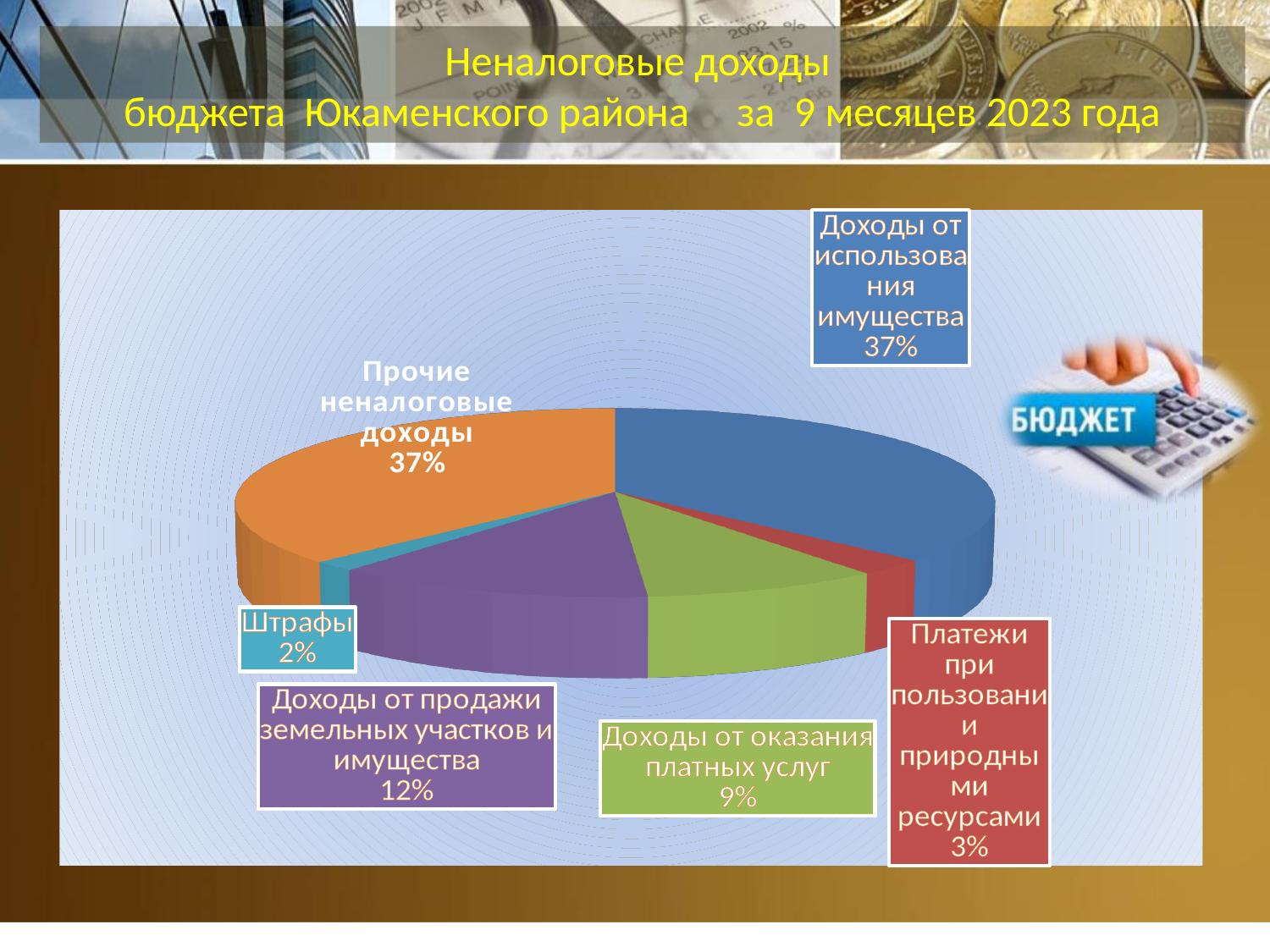
Which category has the smallest share of the pie? Штрафы Which is larger: Доходы от продажи земельных участков и имущества or Доходы от оказания платных услуг? Доходы от продажи земельных участков и имущества What share of the pie is labelled for Доходы от использования имущества? 37% How many categories (slices) does the pie chart show? 6 What kind of chart is shown on the slide? Pie chart What percentage is shown for Доходы от оказания платных услуг? 9% What is the difference between the shares of Прочие неналоговые доходы and Доходы от продажи земельных участков и имущества? 25 percentage points What percentage is shown for Платежи при пользовании природными ресурсами? 3% What percentage is shown for Доходы от продажи земельных участков и имущества? 12% What is the title of the slide? Неналоговые доходы бюджета Юкаменского района за 9 месяцев 2023 года By how many percentage points does Доходы от продажи земельных участков и имущества exceed Доходы от оказания платных услуг? 3 percentage points What percentage is shown for Штрафы? 2%